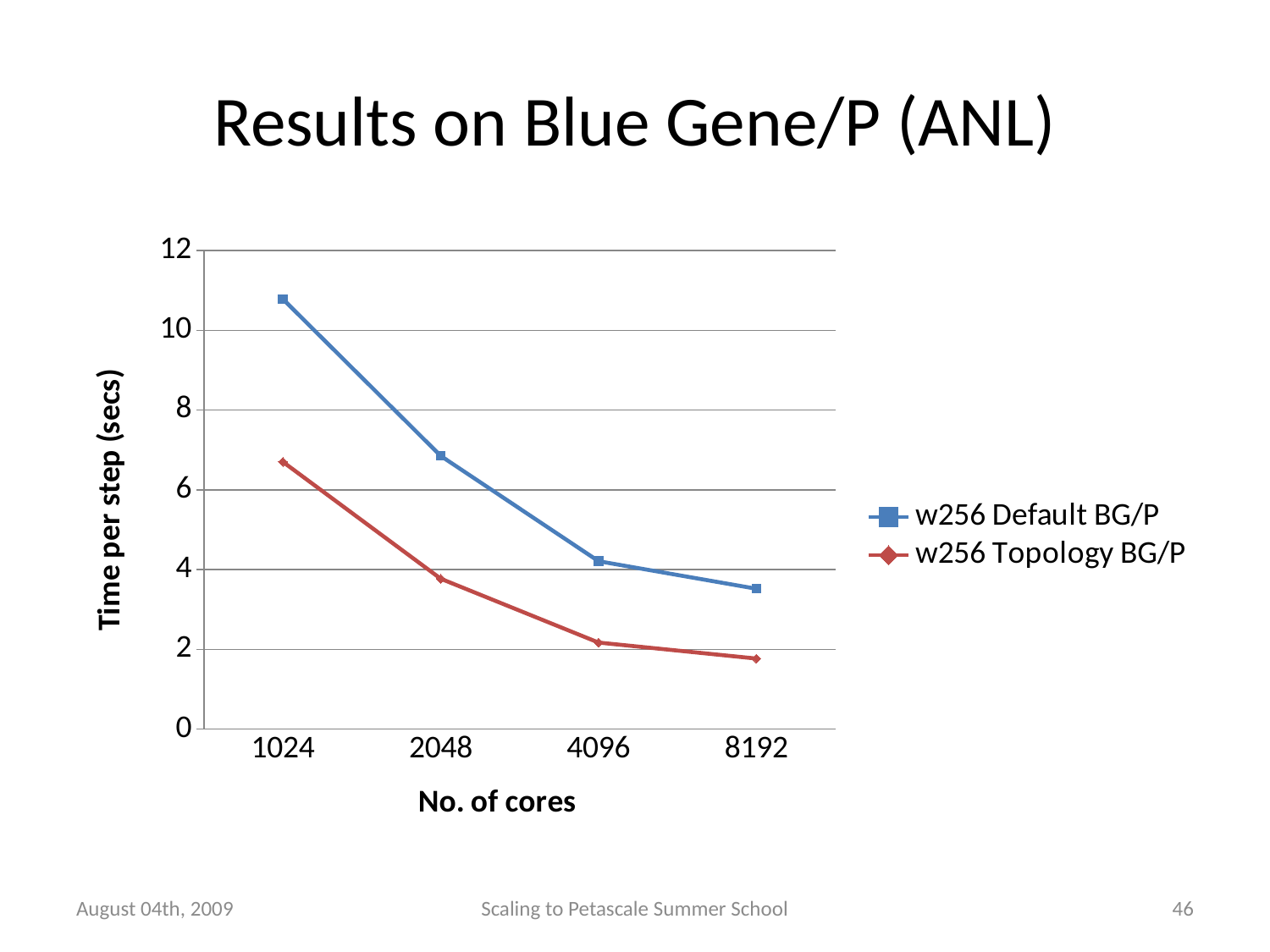
Is the time per step for w256 Topology BG/P at 1024 cores greater or less than 6? greater At 2048 cores, which series has the larger time per step, w256 Default BG/P or w256 Topology BG/P? w256 Default BG/P Does the time per step for w256 Default BG/P rise or fall as the number of cores increases? fall Is the time per step for w256 Default BG/P at 1024 cores greater or less than 10? greater What is the label of the y axis? Time per step (secs) At which number of cores is the time per step for w256 Default BG/P highest? 1024 How many core counts are plotted along the x axis? 4 Does the time per step for w256 Topology BG/P rise or fall as the number of cores increases? fall What kind of chart is shown on the slide? line chart At which number of cores is the time per step for w256 Topology BG/P lowest? 8192 Is the time per step for w256 Default BG/P at 8192 cores greater or less than 4? less How many series does the legend list? 2